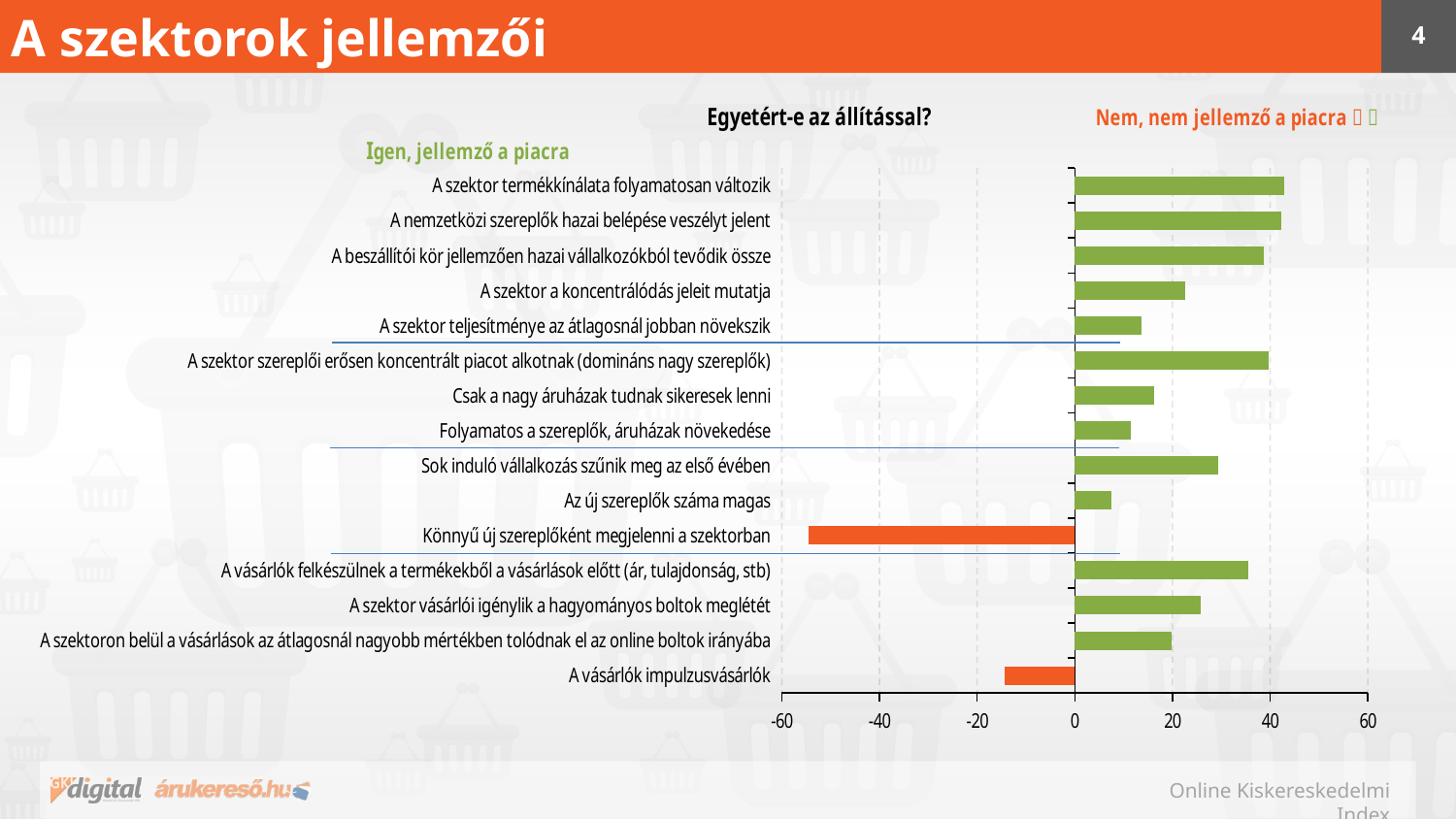
Is the value for "Sok induló vállalkozás szűnik meg az első évében" greater or less than 20? greater Which has the larger value: "Csak a nagy áruházak tudnak sikeresek lenni" or "Folyamatos a szereplők, áruházak növekedése"? Csak a nagy áruházak tudnak sikeresek lenni Is the value for "A szektor termékkínálata folyamatosan változik" greater or less than 20? greater Is the value for "Könnyű új szereplőként megjelenni a szektorban" greater or less than -40? less How many statements (categories) are plotted in the chart? 15 What label is shown in green above the chart for the positive side? Igen, jellemző a piacra How many statements have a negative (orange) bar in the chart? 2 What kind of chart is shown on the slide? bar chart Which has the larger value: "Sok induló vállalkozás szűnik meg az első évében" or "Az új szereplők száma magas"? Sok induló vállalkozás szűnik meg az első évében Which statement has the lowest value in the chart? Könnyű új szereplőként megjelenni a szektorban